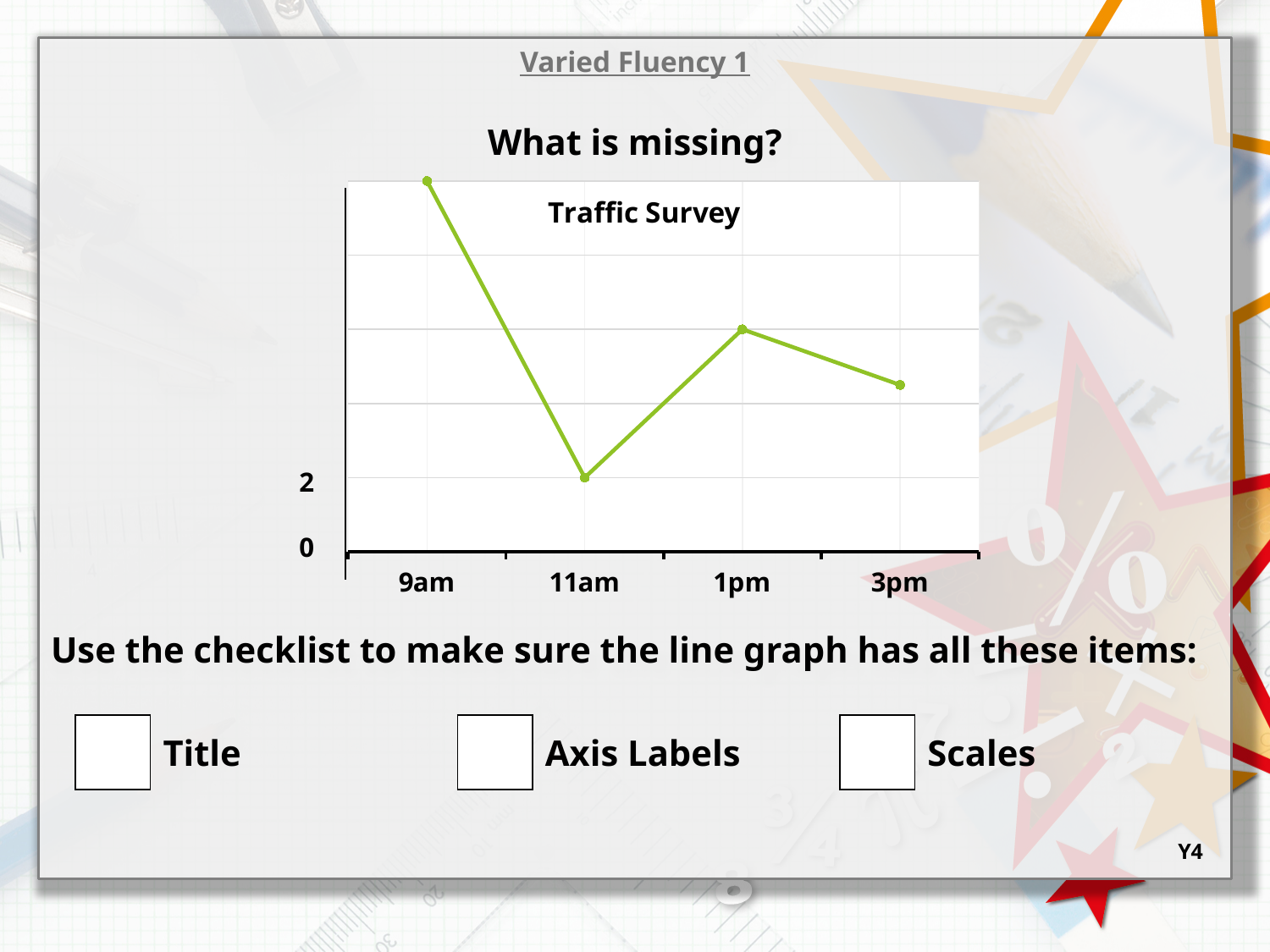
How many time points are plotted on the chart? 4 What colour is the line on the chart? green Is the value for 9am greater or less than 2? greater At which time is the plotted value highest? 9am Which has the larger value, 9am or 1pm? 9am What is the title of the chart? Traffic Survey Is the value for 3pm greater or less than 2? greater What type of chart is shown on the slide? line chart Which has the larger value, 1pm or 3pm? 1pm What is the value plotted at 11am? 2 At which time is the plotted value lowest? 11am Does the line rise or fall between 9am and 11am? fall